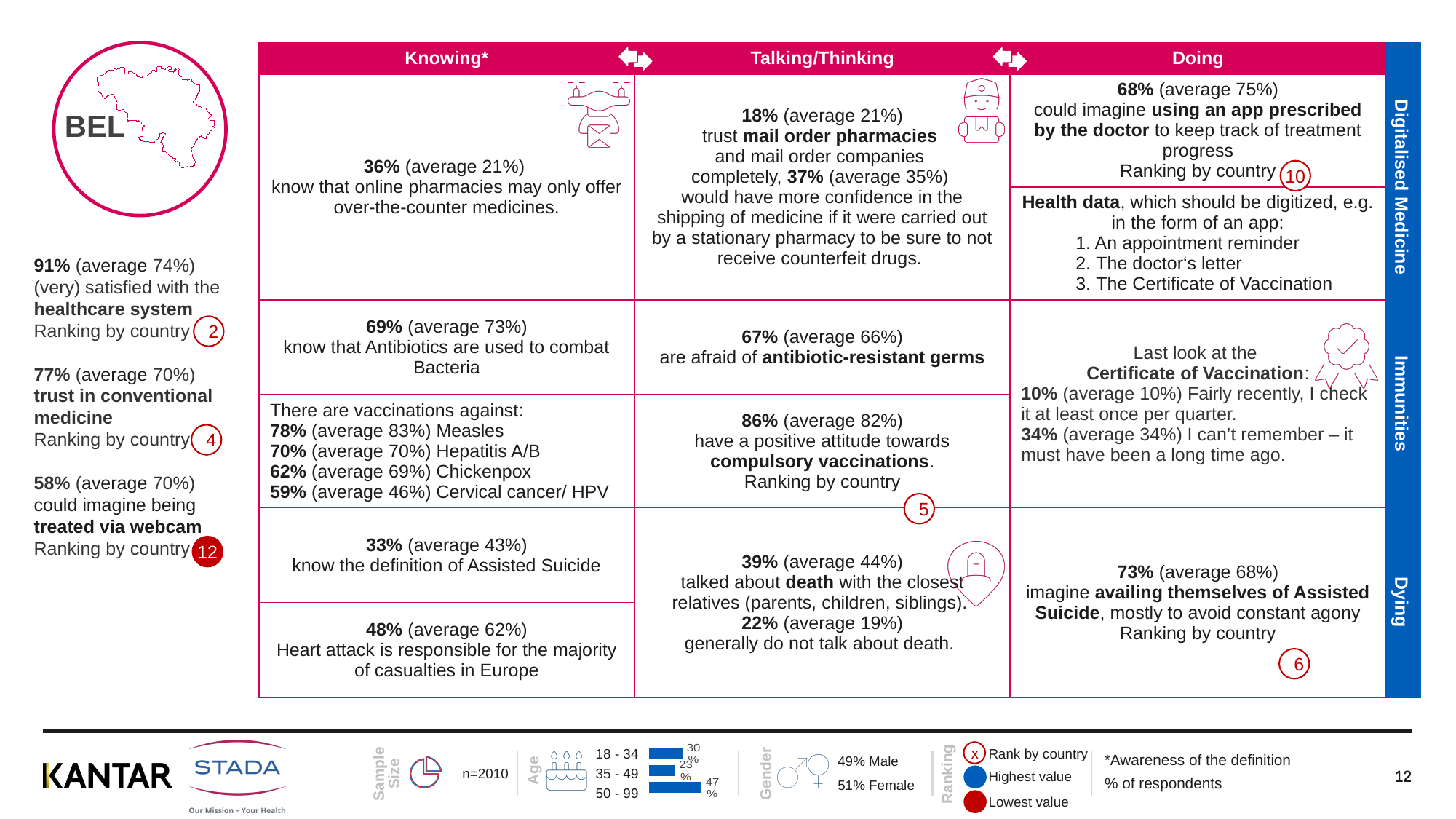
In the Age bar chart at the bottom of the slide, which is larger: the value for 18 - 34 or for 35 - 49? 18 - 34 In the Age bar chart at the bottom of the slide, what is the value for the 18 - 34 age group? 30% In the Age bar chart at the bottom of the slide, which age group has the lowest value? 35 - 49 In the Age bar chart at the bottom of the slide, what is the difference between the 50 - 99 and 18 - 34 values? 17% In the Age bar chart at the bottom of the slide, what is the value for the 50 - 99 age group? 47% In the Age bar chart at the bottom of the slide, what is the difference between the 18 - 34 and 35 - 49 values? 7% How many age groups are shown in the Age bar chart at the bottom of the slide? 3 What kind of chart is the Age chart at the bottom of the slide? Bar chart In the Age bar chart at the bottom of the slide, what is the value for the 35 - 49 age group? 23% Are the bars in the Age chart at the bottom of the slide horizontal or vertical? Horizontal In the Age bar chart at the bottom of the slide, which age group has the highest value? 50 - 99 In the Age bar chart at the bottom of the slide, which is larger: the value for 50 - 99 or for 35 - 49? 50 - 99